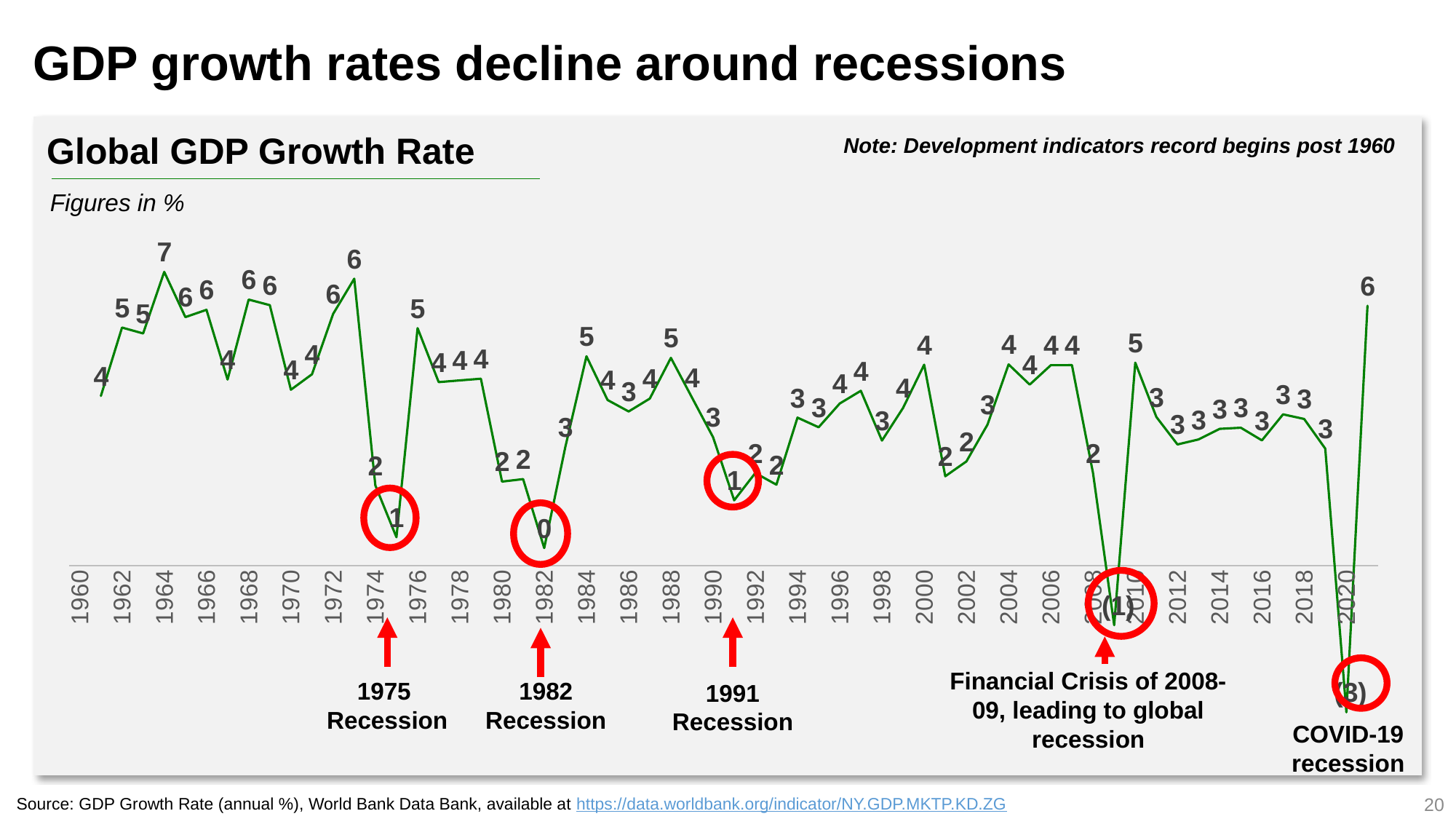
What is the Global GDP Growth Rate for 1982? 0 What is the difference between the Global GDP Growth Rate in 1964 and in 1982? 7 Which year has a higher Global GDP Growth Rate, 1975 or 1976? 1976 What type of chart is shown on the slide? line chart Which year has the highest Global GDP Growth Rate? 1964 Which year has the lowest Global GDP Growth Rate? 2020 What is the Global GDP Growth Rate for 1964? 7 What is the Global GDP Growth Rate for 1984? 5 What unit are the figures in the Global GDP Growth Rate chart expressed in? % What is the Global GDP Growth Rate for 1975? 1 How many recession events are annotated with red circles on the chart? 5 What is the Global GDP Growth Rate for 2020? (3)